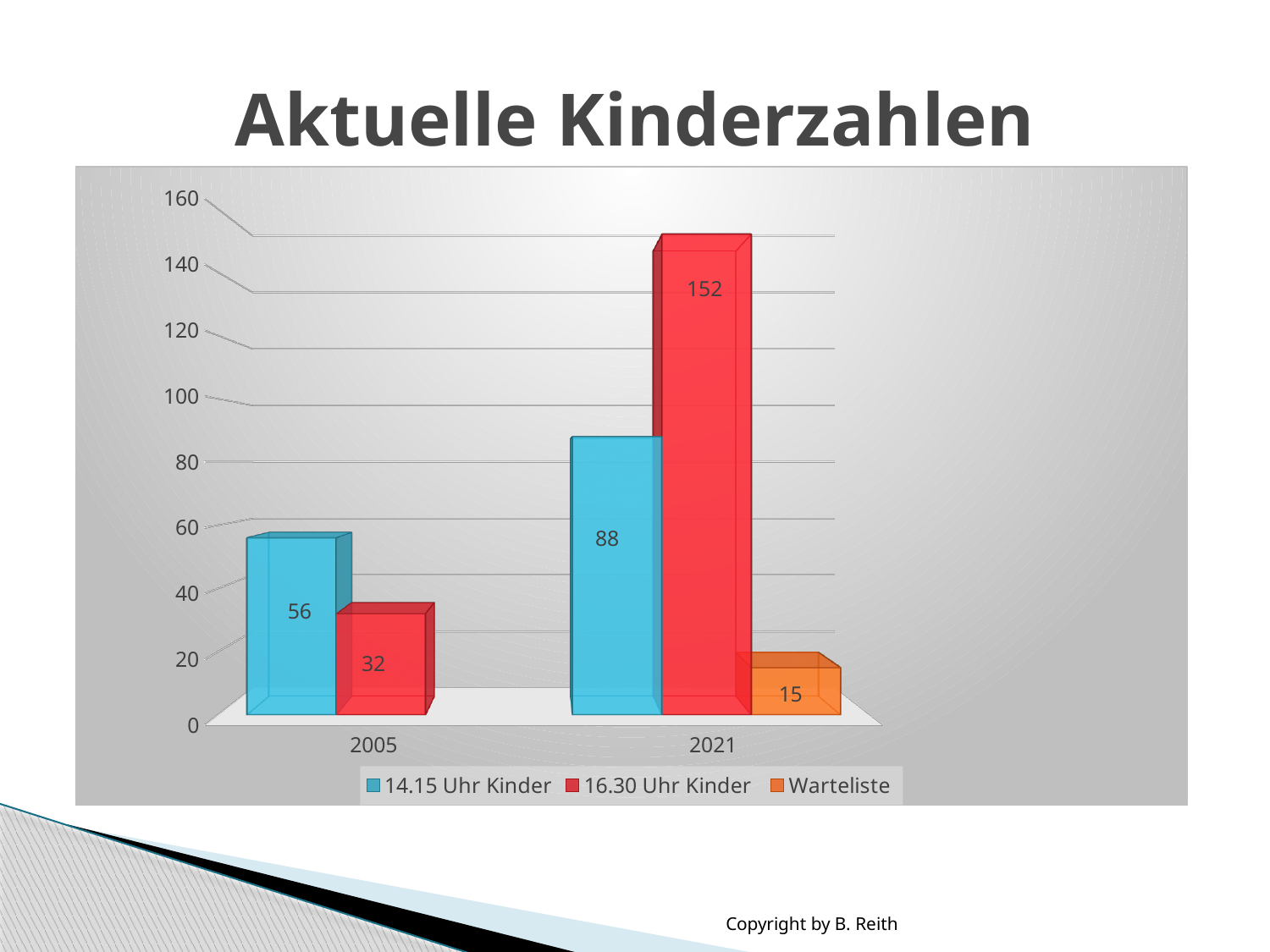
What is the title of the chart? Aktuelle Kinderzahlen Which series has the lowest value in 2021? Warteliste Which is larger in 2005: 14.15 Uhr Kinder or 16.30 Uhr Kinder? 14.15 Uhr Kinder How many series does the legend list? 3 What is the value for 16.30 Uhr Kinder in 2021? 152 How many categories are shown on the x axis? 2 What is the value for 16.30 Uhr Kinder in 2005? 32 What is the difference between the 16.30 Uhr Kinder values for 2021 and 2005? 120 Which series has the highest value in 2021? 16.30 Uhr Kinder What is the value for Warteliste in 2021? 15 What is the value for 14.15 Uhr Kinder in 2005? 56 What kind of chart is shown on the slide? Bar chart